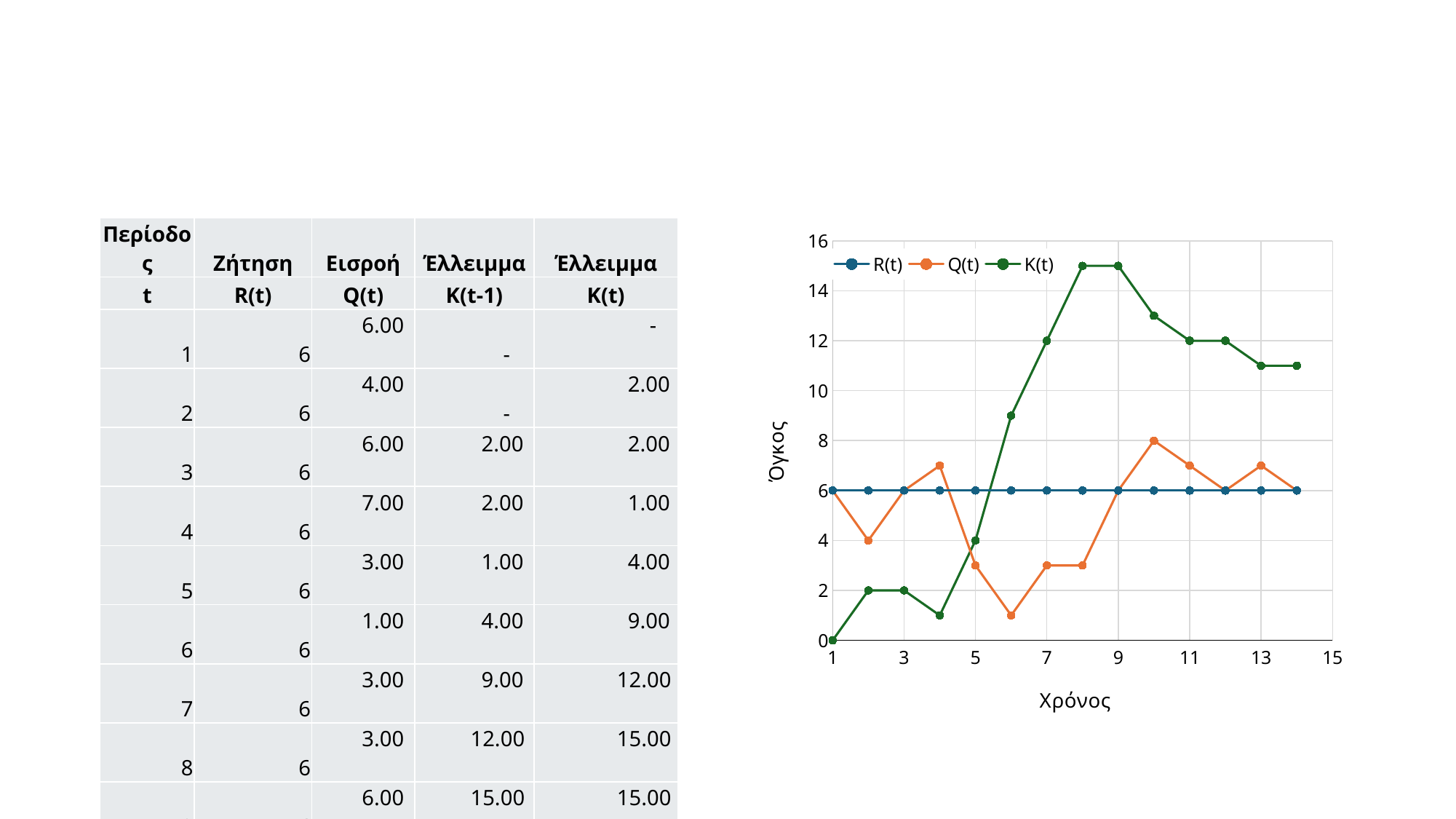
What are the series names listed in the chart's legend? R(t), Q(t), K(t) What kind of chart is shown on the slide? line chart Is the value of Q(t) at time 6 greater or less than 2? less What is the title of the chart's x axis? Χρόνος What is the value of K(t) at time 7 in the chart? 12 Does K(t) rise or fall between time 9 and time 14? fall How many series does the chart's legend list? 3 What is the value of Q(t) at time 10 in the chart? 8 What is the value of R(t) at time 7 in the chart? 6 Is the value of K(t) at time 9 greater or less than 14? greater Which series has the highest value at time 13? K(t) What is the value of K(t) at time 1 in the chart? 0